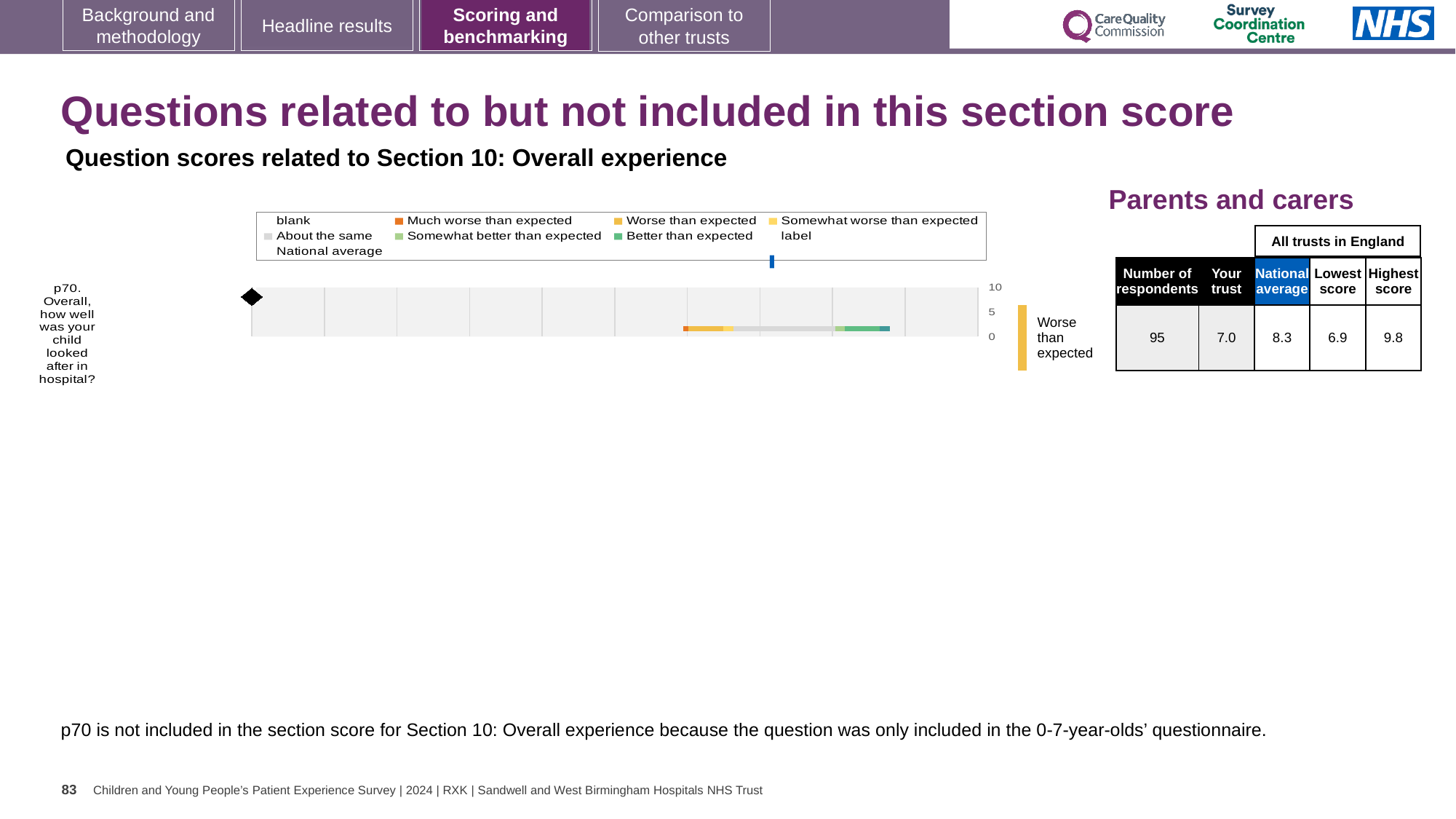
What is the highest score among all trusts in England for p70? 9.8 What type of chart is used to show the p70 question score? bar chart What is the lowest score among all trusts in England for p70? 6.9 What is the 'Your trust' score for p70 shown in the table next to the chart? 7.0 Which is larger for p70, the trust's score or the national average? National average Which benchmark category is the trust's p70 result labelled as, to the right of the chart? Worse than expected How many respondents answered p70? 95 What is the difference between the national average and the trust's score for p70? 1.3 How many questions are plotted in the chart? 1 What is the maximum value shown on the chart's score axis? 10 What is the national average score for p70? 8.3 What is the difference between the highest and lowest trust scores for p70? 2.9